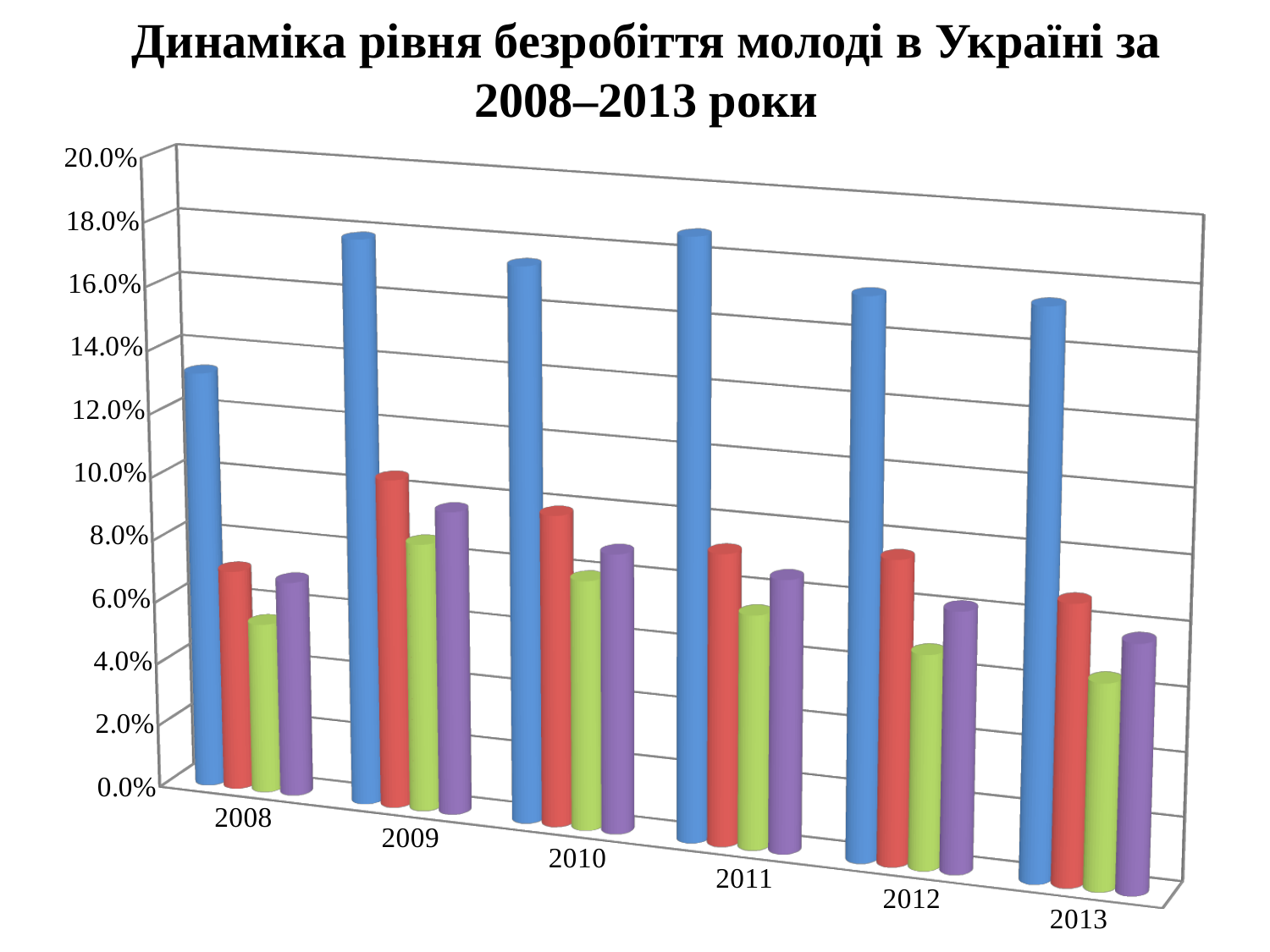
In which year is the red bar the tallest? 2009 How many bars are plotted for each year in the chart? 4 Is the value of the blue bar for 2009 greater or less than 16.0%? greater How many years (categories) are shown on the x axis of the chart? 6 What is the title of the chart? Динаміка рівня безробіття молоді в Україні за 2008–2013 роки Which is larger: the blue bar for 2008 or the blue bar for 2009? 2009 Is the value of the red bar for 2009 greater or less than 12.0%? less In which year is the green bar the shortest? 2013 What is the highest value shown on the vertical axis of the chart? 20.0% What type of chart is shown on the slide? bar chart Is the value of the blue bar for 2008 greater or less than 10.0%? greater